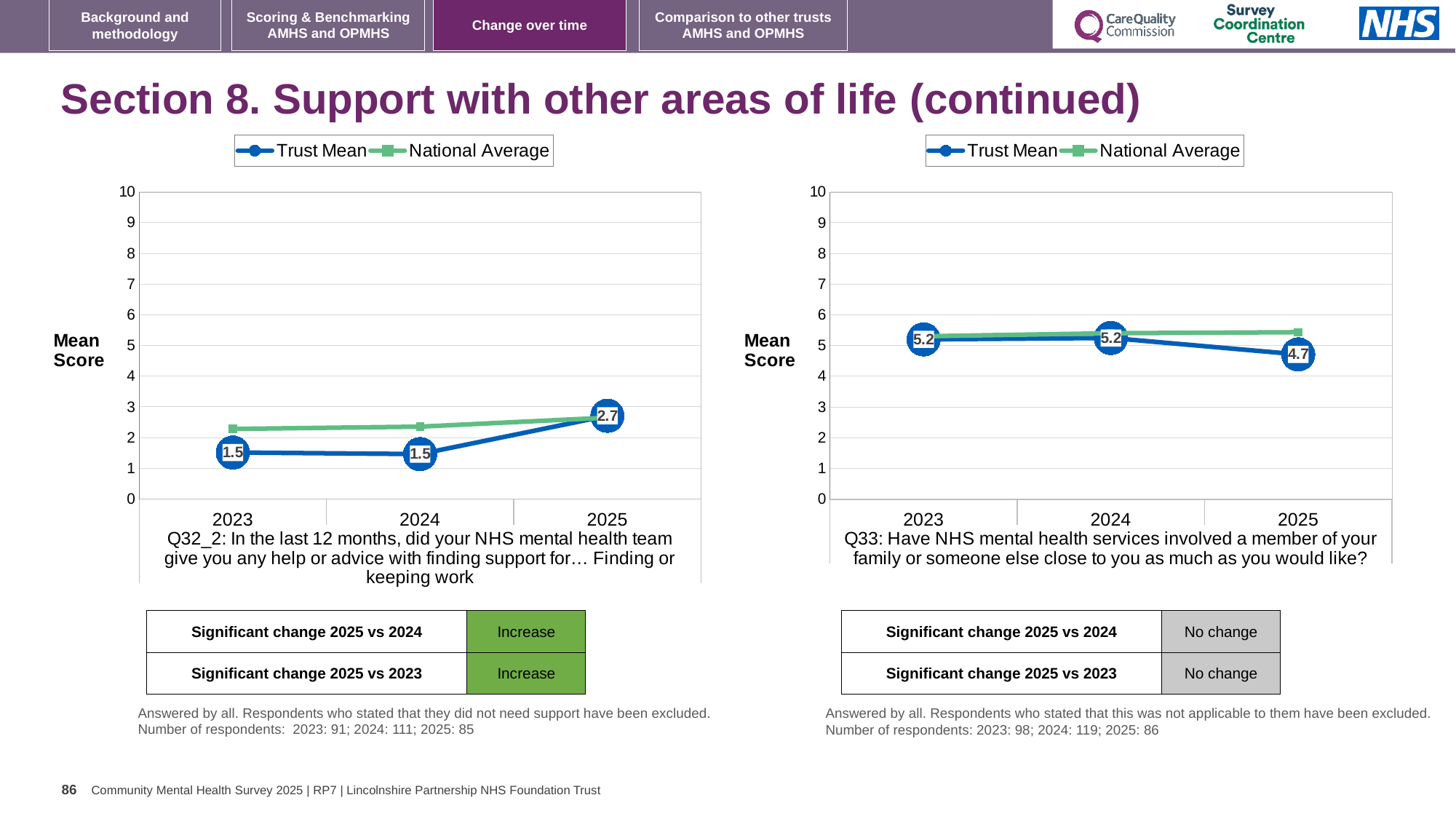
In the left chart (Q32_2), is the National Average value for 2023 greater or less than 2? greater In the right chart (Q33), which year has the lowest Trust Mean score? 2025 In the right chart (Q33), by how much did the Trust Mean fall from 2024 to 2025? 0.5 In the right chart (Q33), what is the Trust Mean score for 2025? 4.7 In the left chart (Q32_2), what is the Trust Mean score for 2023? 1.5 In the left chart (Q32_2), which year has the highest Trust Mean score? 2025 In the right chart (Q33), what is the Trust Mean score for 2024? 5.2 In the left chart (Q32_2), what is the Trust Mean score for 2025? 2.7 In the left chart (Q32_2), by how much did the Trust Mean increase from 2024 to 2025? 1.2 How many series does the legend of the right chart (Q33) list? 2 What kind of chart is the left chart (Q32_2)? Line chart In the right chart (Q33), is the Trust Mean or the National Average higher in 2025? National Average